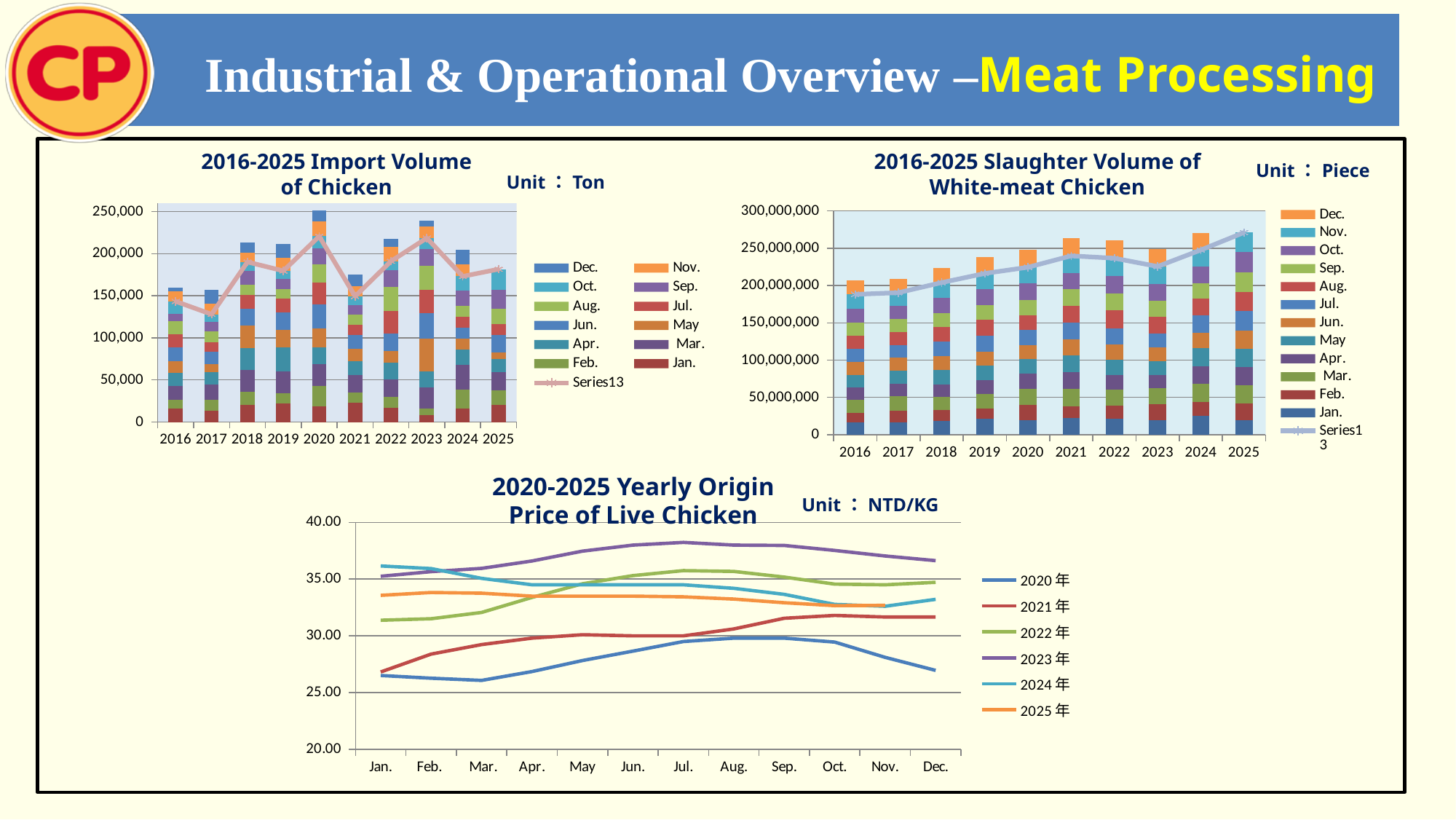
On the 2016-2025 Import Volume of Chicken chart, how many years are shown on the x axis? 10 On the 2016-2025 Slaughter Volume of White-meat Chicken chart, is the total for 2016 greater or less than 250,000,000? less On the 2016-2025 Import Volume of Chicken chart, is the total for 2023 greater or less than 200,000? greater On the 2016-2025 Import Volume of Chicken chart, is the total for 2021 greater or less than 200,000? less On the 2016-2025 Slaughter Volume of White-meat Chicken chart, which is larger, the total for 2018 or the total for 2021? 2021 What kind of chart is the 2020-2025 Yearly Origin Price of Live Chicken chart? line chart On the 2020-2025 Yearly Origin Price of Live Chicken chart, which year's line is the highest in July? 2023年 On the 2016-2025 Import Volume of Chicken chart, what unit is stated for the values? Ton On the 2016-2025 Import Volume of Chicken chart, which year has the highest total import volume? 2020 On the 2016-2025 Slaughter Volume of White-meat Chicken chart, do the yearly totals generally rise or fall from 2016 to 2025? rise How many series does the legend of the 2020-2025 Yearly Origin Price of Live Chicken chart list? 6